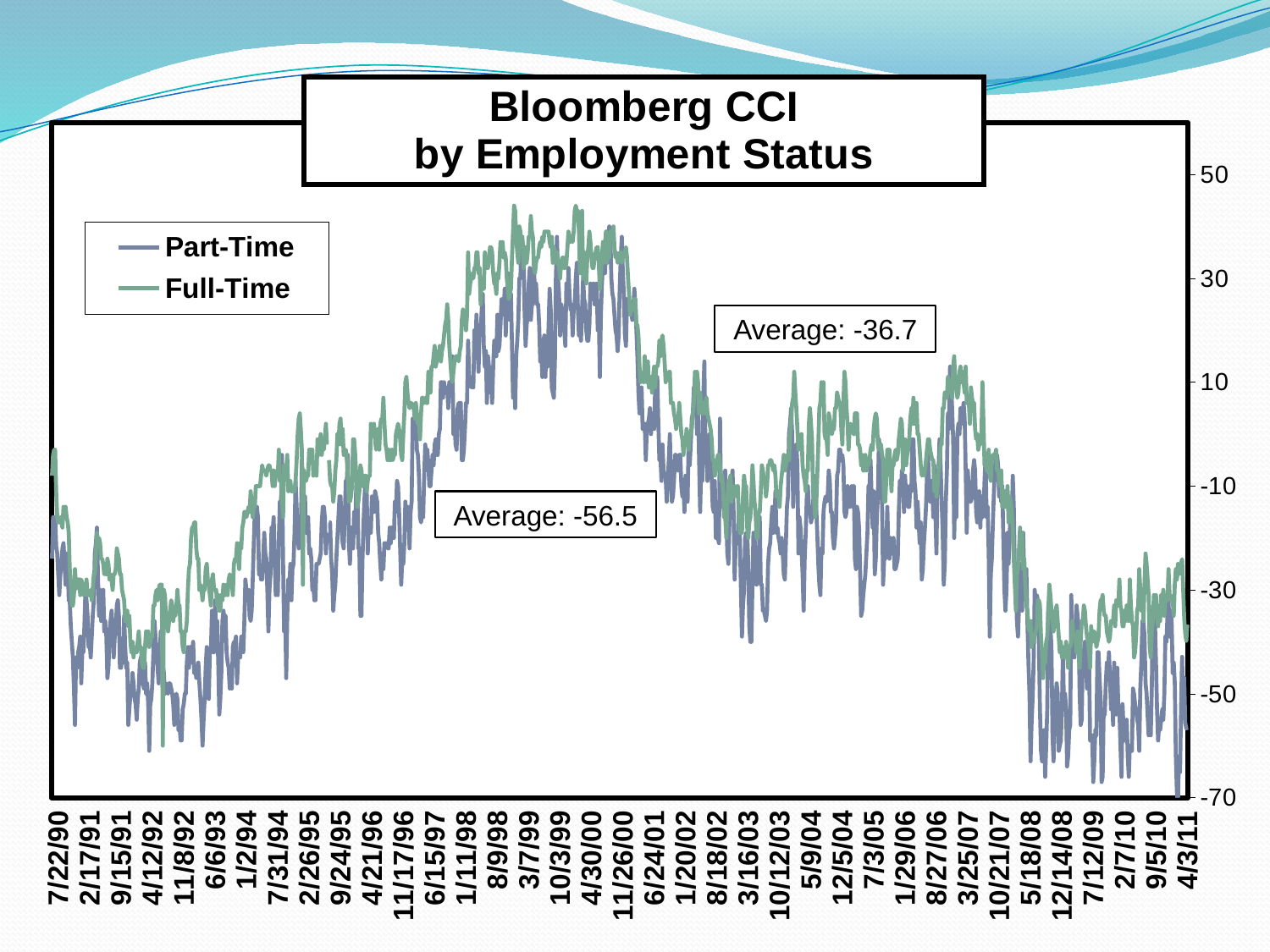
Is the Full-Time value around 3/7/99 greater or less than 30? greater Do the values generally rise or fall from 7/22/90 to 3/7/99? rise What is the lowest value shown on the vertical axis? -70 What is the highest value shown on the vertical axis? 50 What is the last date label on the horizontal axis? 4/3/11 What are the two series named in the legend? Part-Time and Full-Time Around 5/18/08, which series has the higher value, Part-Time or Full-Time? Full-Time Is the Part-Time value around 4/12/92 greater or less than -30? less What is the first date label on the horizontal axis? 7/22/90 What kind of chart is shown on the slide? line chart What is the title of the chart? Bloomberg CCI by Employment Status How many series does the legend list? 2